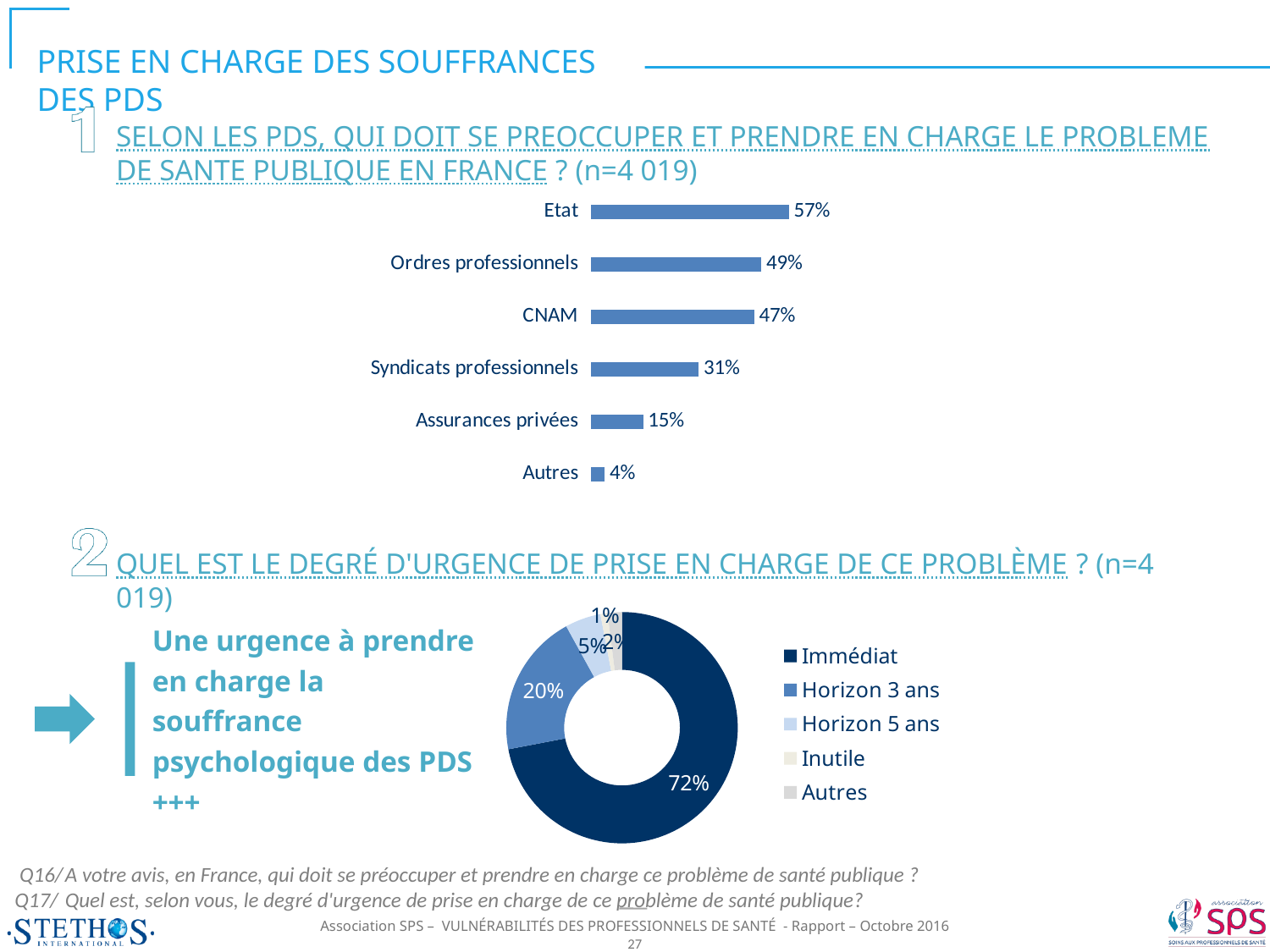
How many entries does the legend of the bottom doughnut chart list? 5 In the top bar chart, what percentage is shown for CNAM? 47% In the top bar chart, which category has the highest value? Etat In the bottom doughnut chart, what percentage is shown for Immédiat? 72% How many categories are shown in the top bar chart? 6 In the top bar chart, what percentage is shown for Assurances privées? 15% What type of chart is the top chart on the slide? Bar chart In the bottom doughnut chart, what percentage is shown for Horizon 3 ans? 20% In the top bar chart, which category has the lowest value? Autres In the top bar chart, which is larger: Ordres professionnels or CNAM? Ordres professionnels In the top bar chart, what percentage is shown for Etat? 57% In the top bar chart, what is the difference between the values for Etat and Syndicats professionnels? 26%